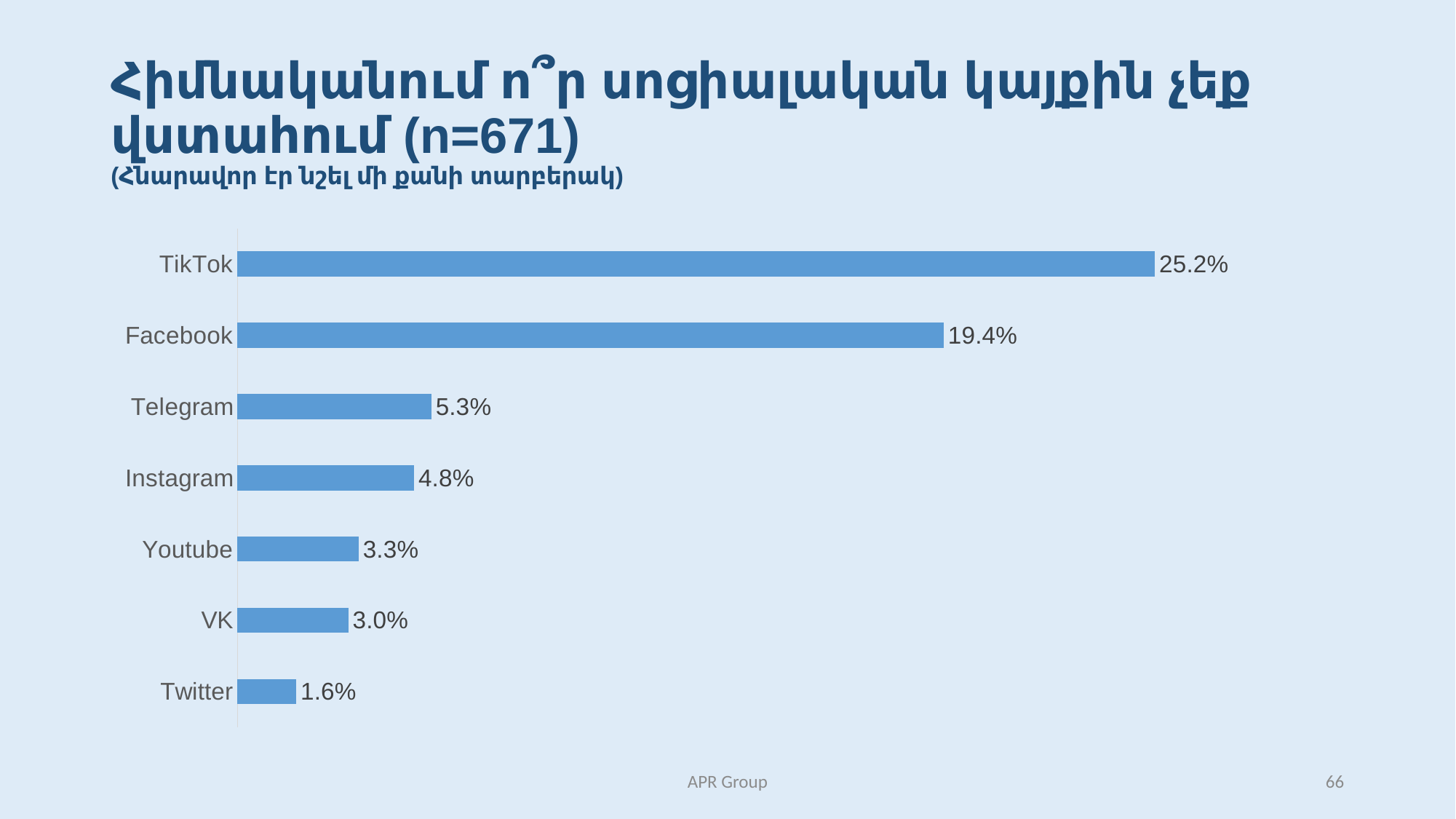
What kind of chart is shown on the slide? Bar chart Which is larger, the value for Telegram or the value for Instagram? Telegram What is the difference between the values for Instagram and Youtube? 1.5% What is the value for Facebook? 19.4% Which category has the highest value? TikTok How many categories are shown in the chart? 7 What is the value for Telegram? 5.3% What is the value for TikTok? 25.2% What is the value for VK? 3.0% What sample size (n) is stated in the chart title? 671 Which category has the lowest value? Twitter What is the difference between the values for TikTok and Facebook? 5.8%